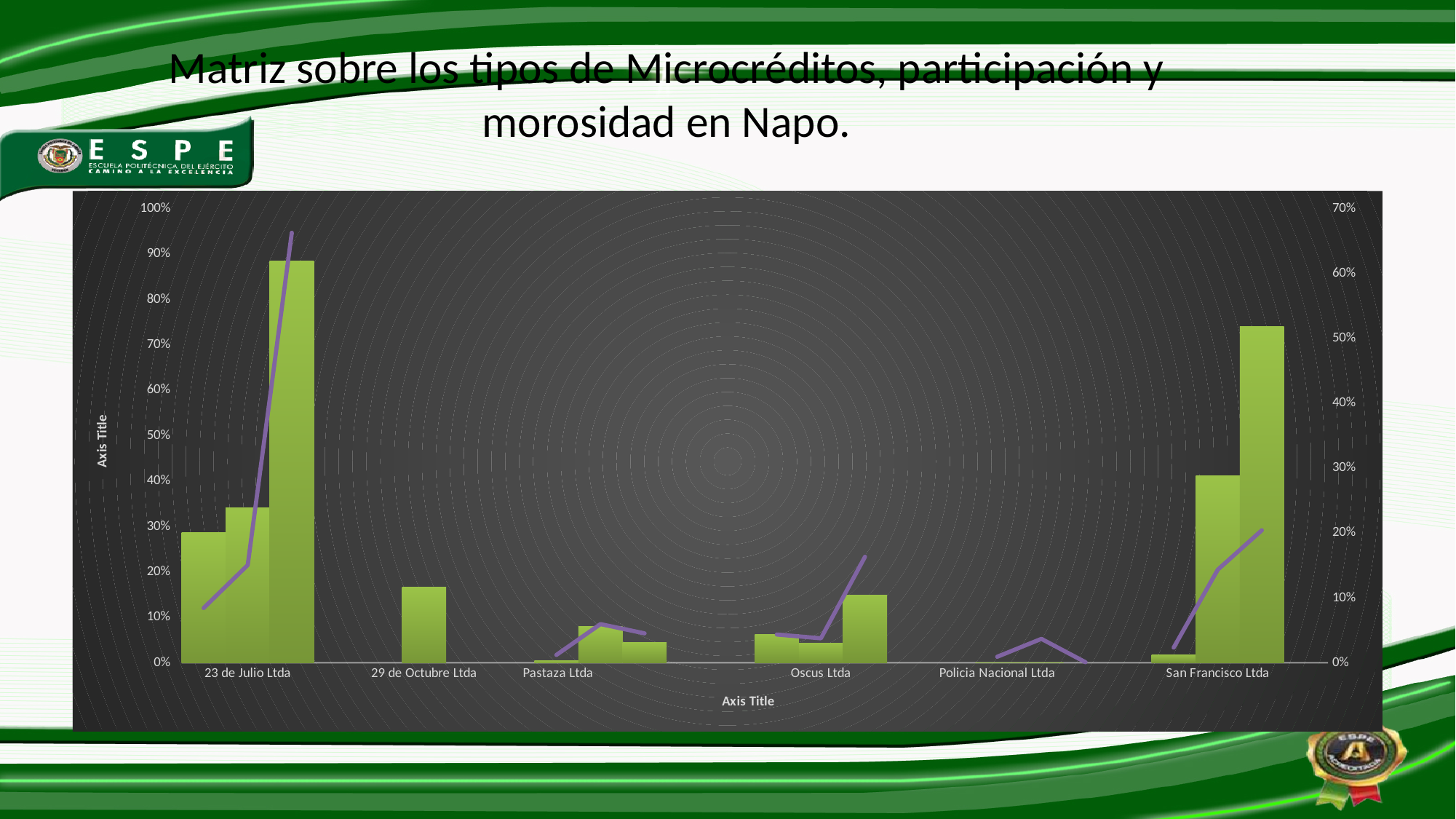
Is the tallest bar for San Francisco Ltda greater or less than 60% on the left axis? greater Which category has the tallest bar in the chart? 23 de Julio Ltda Which category has the lowest bars in the chart? Policia Nacional Ltda Is the tallest bar for 23 de Julio Ltda greater or less than 80% on the left axis? greater What kind of chart is shown on the slide? Bar chart with a line overlay Is the tallest bar for Pastaza Ltda greater or less than 10% on the left axis? less Which has a taller highest bar: 23 de Julio Ltda or San Francisco Ltda? 23 de Julio Ltda What text is shown as the title of the horizontal axis? Axis Title At which category does the purple line reach its highest point? 23 de Julio Ltda What is the highest tick value shown on the right-hand vertical axis? 70% How many categories are shown on the x axis of the chart? 6